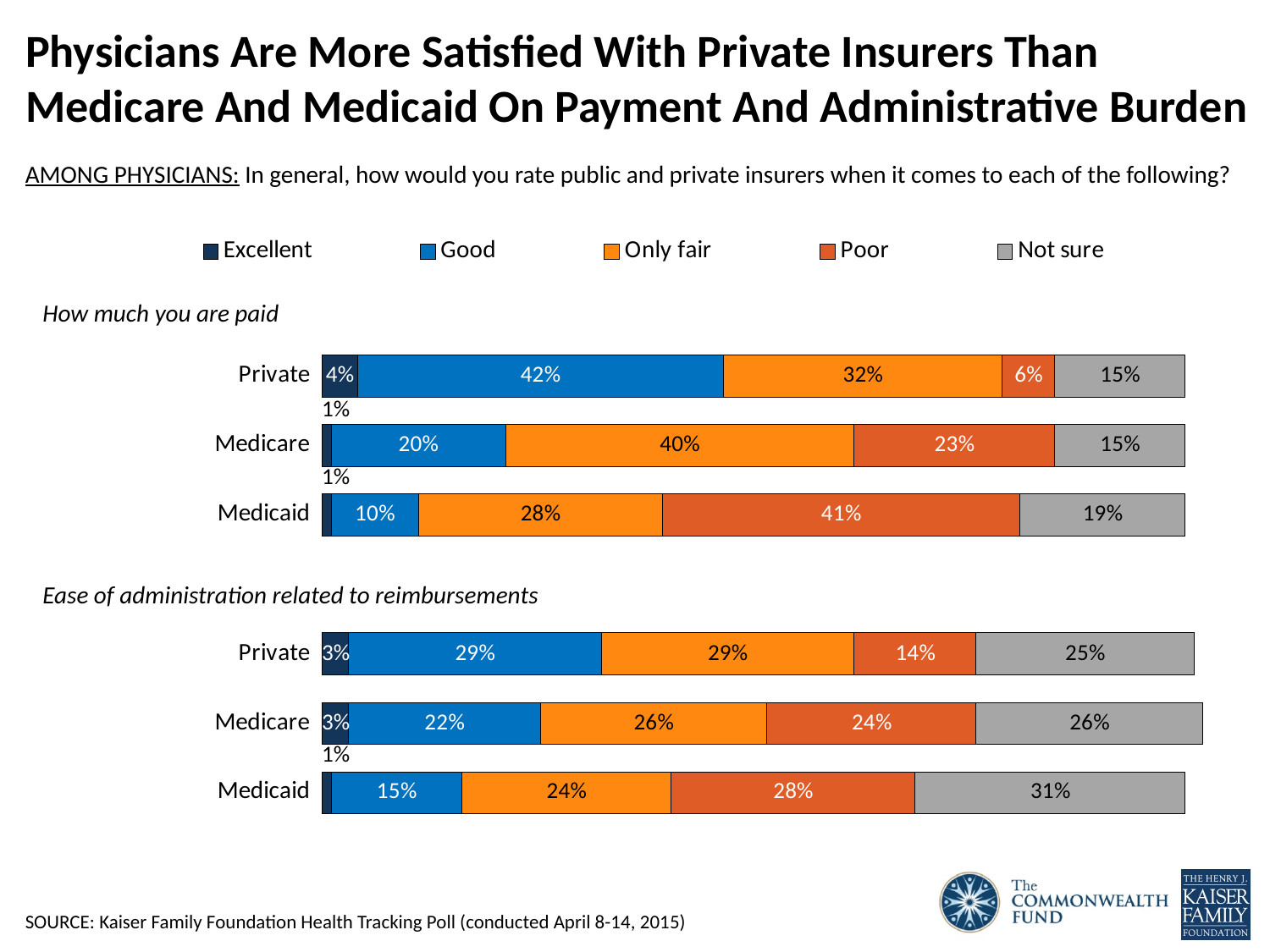
In the 'How much you are paid' chart, what percentage of physicians rated private insurers as Good? 42% In the 'How much you are paid' chart, which insurer has the highest Poor rating? Medicaid In the 'Ease of administration related to reimbursements' chart, what percentage rated Medicare as Not sure? 26% In the 'How much you are paid' chart, what percentage rated Medicaid as Poor? 41% In the 'Ease of administration related to reimbursements' chart, which insurer has the lowest Not sure share? Private What type of chart is used for 'Ease of administration related to reimbursements'? Stacked bar chart In the 'Ease of administration related to reimbursements' chart, what is the total of the Private bar's labeled segments? 100% In the 'Ease of administration related to reimbursements' chart, is the Poor rating larger for Medicare or for Private? Medicare How many insurer categories are shown in the 'How much you are paid' chart? 3 In the 'Ease of administration related to reimbursements' chart, what percentage rated Medicaid as Good? 15% In the 'How much you are paid' chart, what is the difference between the Good rating for Private and the Good rating for Medicare? 22 percentage points How many series does the legend list? 5